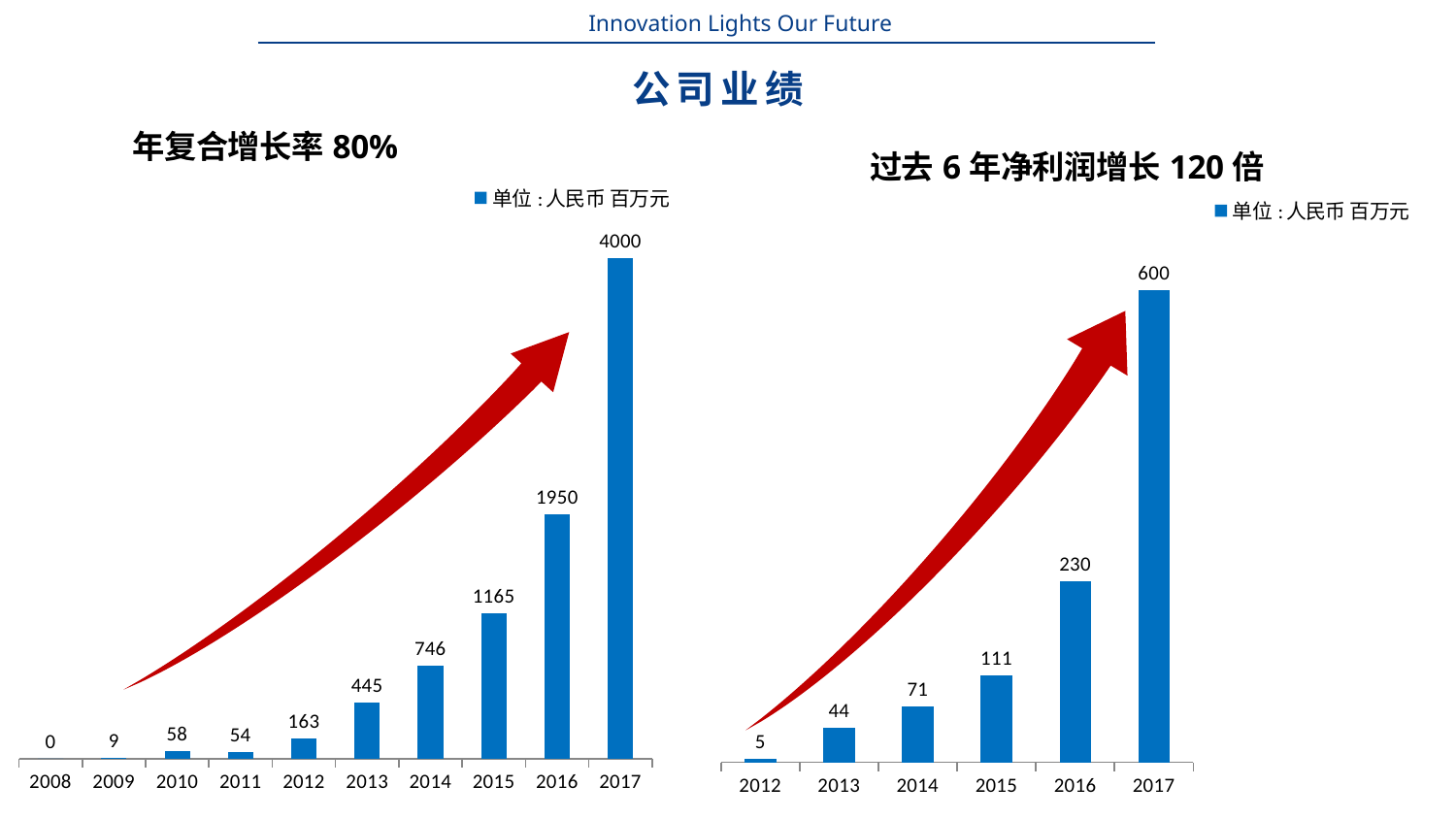
In the left chart (年复合增长率 80%), what is the value for 2011? 54 In the left chart (年复合增长率 80%), which is larger, the value for 2010 or the value for 2011? 2010 In the right chart (过去 6 年净利润增长 120 倍), do the values rise or fall from 2012 to 2017? Rise In the right chart (过去 6 年净利润增长 120 倍), what is the difference between the values for 2016 and 2015? 119 What kind of chart is the left chart (年复合增长率 80%)? Bar chart How many years are shown on the x axis of the left chart (年复合增长率 80%)? 10 In the right chart (过去 6 年净利润增长 120 倍), what is the value for 2015? 111 In the left chart (年复合增长率 80%), what is the value for 2014? 746 How many years are shown on the x axis of the right chart (过去 6 年净利润增长 120 倍)? 6 In the left chart (年复合增长率 80%), what is the difference between the values for 2017 and 2016? 2050 In the right chart (过去 6 年净利润增长 120 倍), which year has the highest value? 2017 In the left chart (年复合增长率 80%), which year has the lowest value? 2008